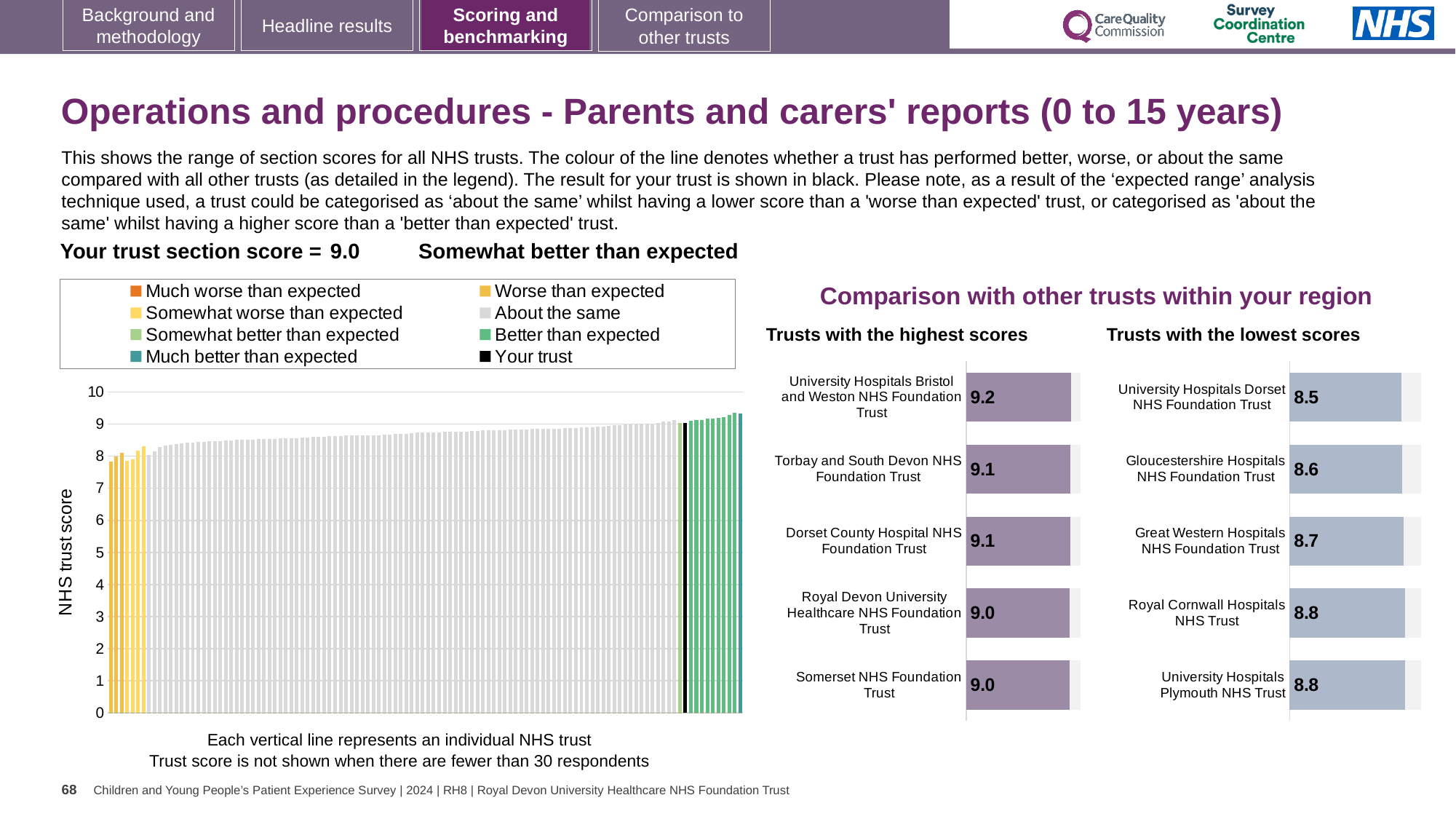
In the 'Trusts with the lowest scores' chart, which has the higher score: Gloucestershire Hospitals NHS Foundation Trust or Great Western Hospitals NHS Foundation Trust? Great Western Hospitals NHS Foundation Trust What kind of chart is the large chart on the left showing NHS trust scores? Bar chart In the 'Trusts with the highest scores' chart, what is the difference between the scores of University Hospitals Bristol and Weston NHS Foundation Trust and Somerset NHS Foundation Trust? 0.2 In the 'Trusts with the lowest scores' chart, what is the score for University Hospitals Plymouth NHS Trust? 8.8 In the 'Trusts with the lowest scores' chart, what is the difference between the scores of Royal Cornwall Hospitals NHS Trust and University Hospitals Dorset NHS Foundation Trust? 0.3 In the 'Trusts with the highest scores' chart, what is the score for University Hospitals Bristol and Weston NHS Foundation Trust? 9.2 In the 'Trusts with the highest scores' chart, which trust has the highest score? University Hospitals Bristol and Weston NHS Foundation Trust In the 'Trusts with the lowest scores' chart, which trust has the lowest score? University Hospitals Dorset NHS Foundation Trust In the 'Trusts with the highest scores' chart, how many trusts are shown? 5 In the large chart on the left, is the value for the black 'Your trust' bar greater or less than 8? greater In the 'Trusts with the lowest scores' chart, what is the score for Great Western Hospitals NHS Foundation Trust? 8.7 How many entries does the legend of the large chart on the left list? 8